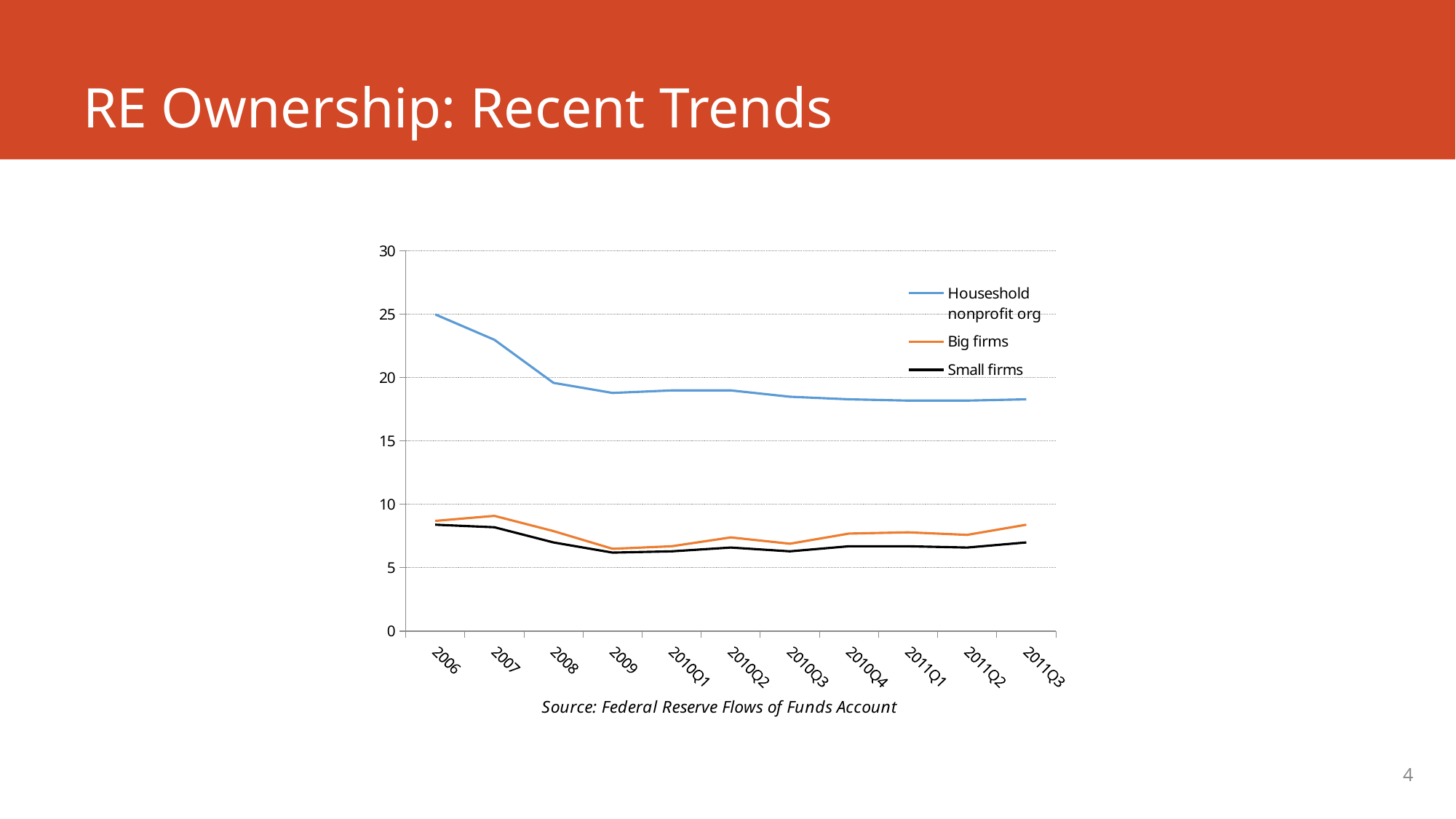
Is the value for Houseshold nonprofit org in 2006 greater or less than 20? greater How many series does the legend list? 3 Is the value for Houseshold nonprofit org in 2011Q3 greater or less than 20? less Which series has the highest values across the whole chart? Houseshold nonprofit org Is the value for Small firms in 2009 greater or less than 5? greater Which is larger in 2008, the value for Big firms or the value for Small firms? Big firms Which series has the lowest value in 2009? Small firms What source is cited below the chart? Federal Reserve Flows of Funds Account Does the Houseshold nonprofit org series rise or fall from 2006 to 2009? fall How many points are plotted along the x axis for each series? 11 What kind of chart is shown on the slide? line chart